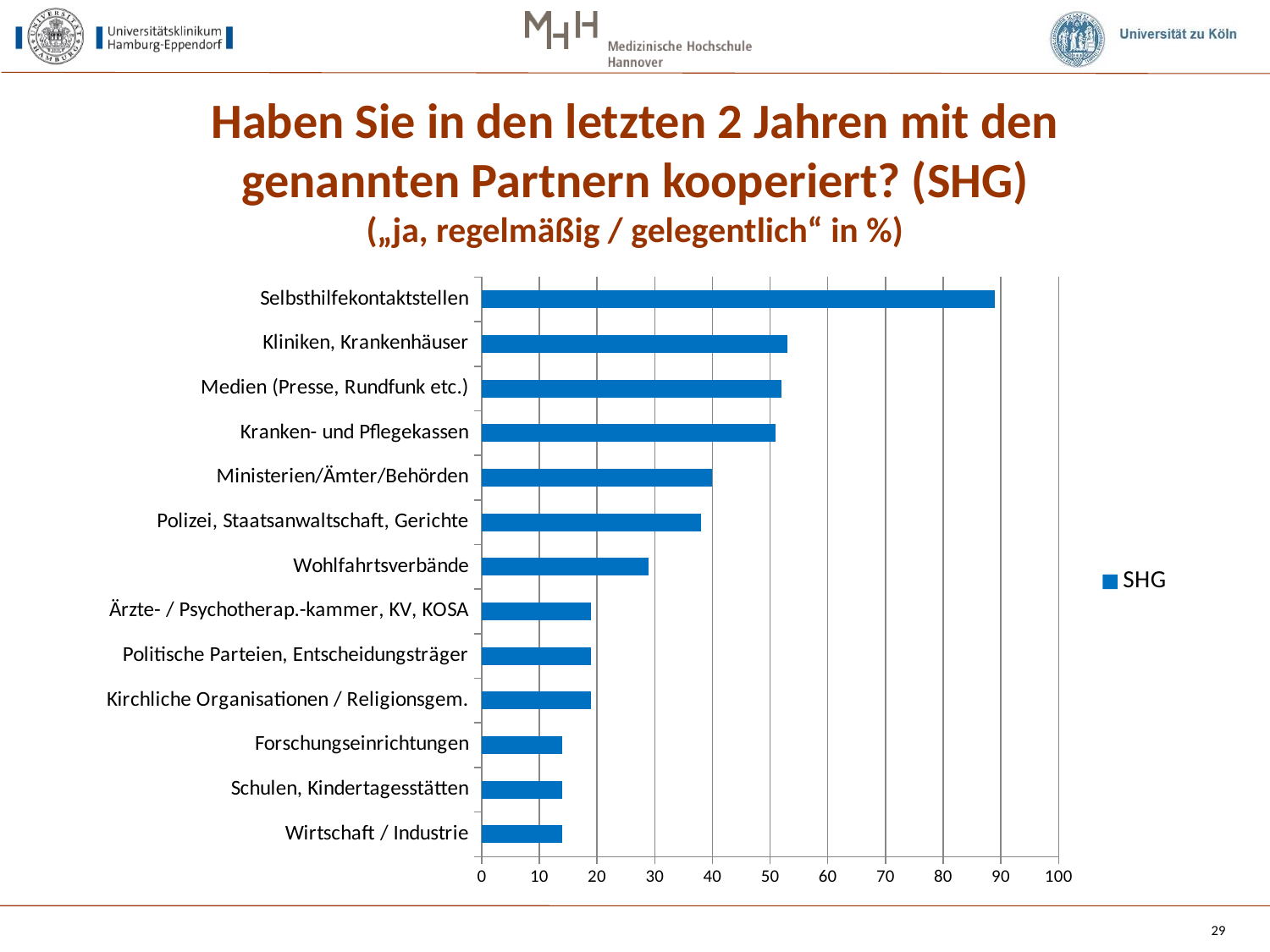
Is the value for Kliniken, Krankenhäuser greater or less than 50? greater Which is larger, the value for Selbsthilfekontaktstellen or the value for Kliniken, Krankenhäuser? Selbsthilfekontaktstellen Which partner category has the highest value? Selbsthilfekontaktstellen Is the value for Ministerien/Ämter/Behörden greater or less than 30? greater Which is larger, the value for Wohlfahrtsverbände or the value for Wirtschaft / Industrie? Wohlfahrtsverbände Is the value for Selbsthilfekontaktstellen greater or less than 80? greater How many series does the legend list? 1 What kind of chart is shown on the slide? bar chart What series name is shown in the legend? SHG How many partner categories are listed on the chart? 13